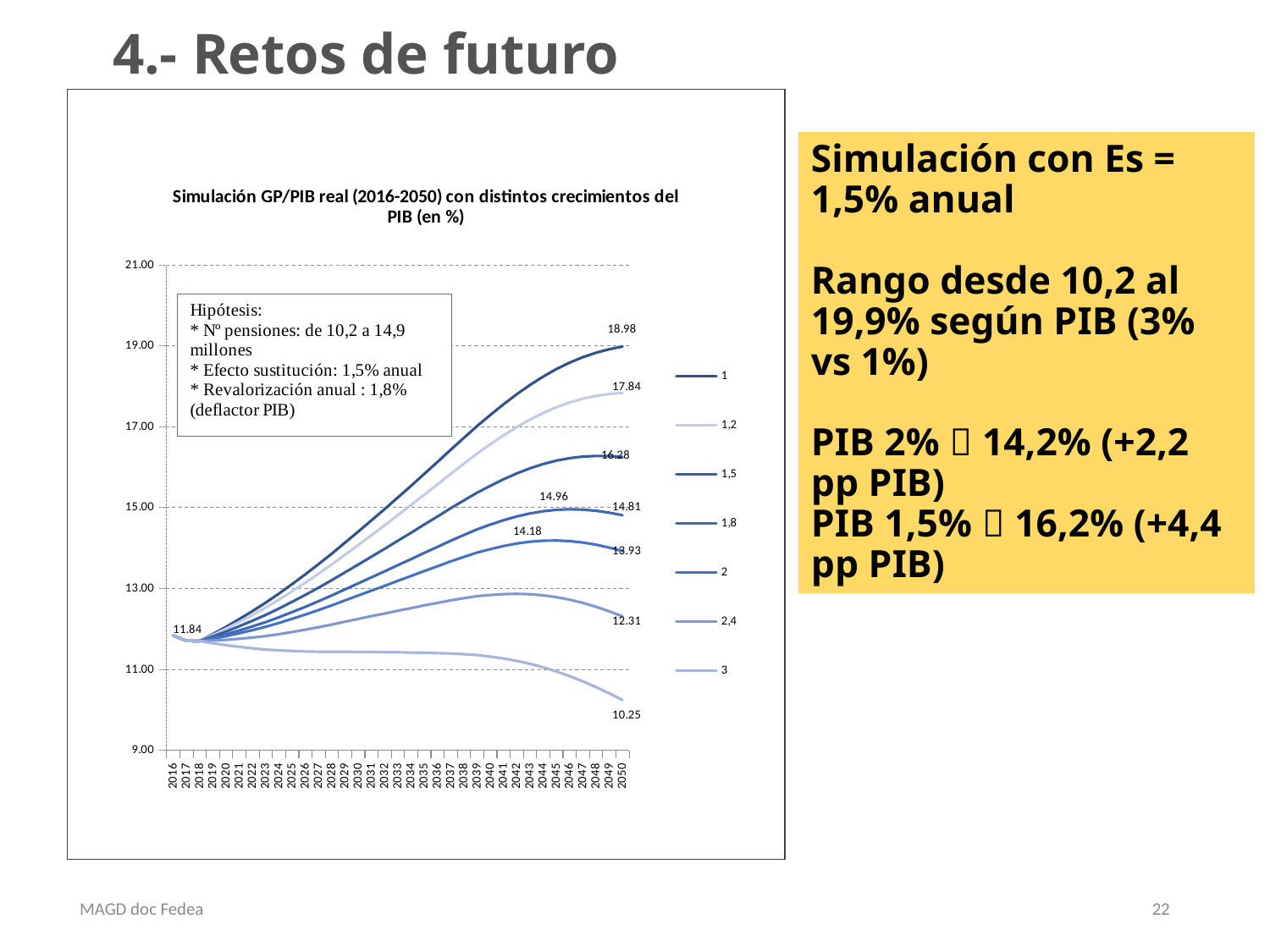
What is the difference between the 2050 values of series 1 and series 3? 8.73 What is the value of series 1 in 2050? 18.98 What is the starting value of the series in 2016? 11.84 How many series does the chart legend list? 7 Is the value of series 1 in 2040 greater or less than 15.00? greater What type of chart is shown on the slide? Line chart Which series has the larger value in 2050, series 1,2 or series 1,5? 1,2 Which series has the lowest value in 2050? 3 Which series has the highest value in 2050? 1 What is the value of series 3 in 2050? 10.25 What is the title of the chart? Simulación GP/PIB real (2016-2050) con distintos crecimientos del PIB (en %) What is the value of series 1,2 in 2050? 17.84